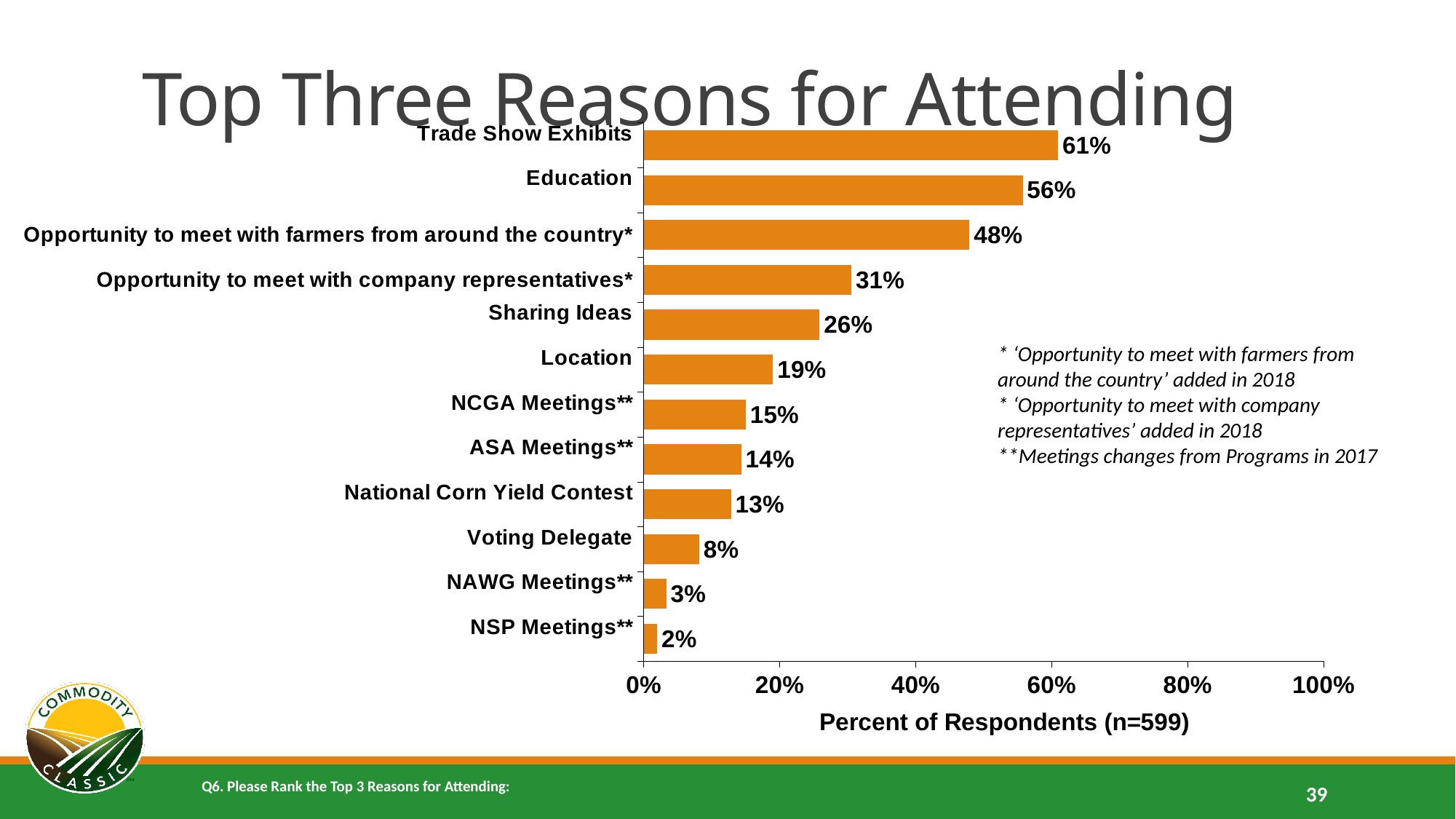
What is the value for Education? 56% Which reason has the highest percentage of respondents? Trade Show Exhibits What is the difference in percentage points between Trade Show Exhibits and Education? 5 Is the value for Opportunity to meet with farmers from around the country* greater or less than 40%? greater How many reasons (categories) are shown in the chart? 12 What kind of chart is shown on the slide? Bar chart Which reason has the lowest percentage of respondents? NSP Meetings** What is the value for Voting Delegate? 8% What percentage is shown for Sharing Ideas? 26% What percentage of respondents chose Trade Show Exhibits as a top three reason for attending? 61% Which has a larger value, Location or NCGA Meetings**? Location What is the x-axis label of the chart? Percent of Respondents (n=599)